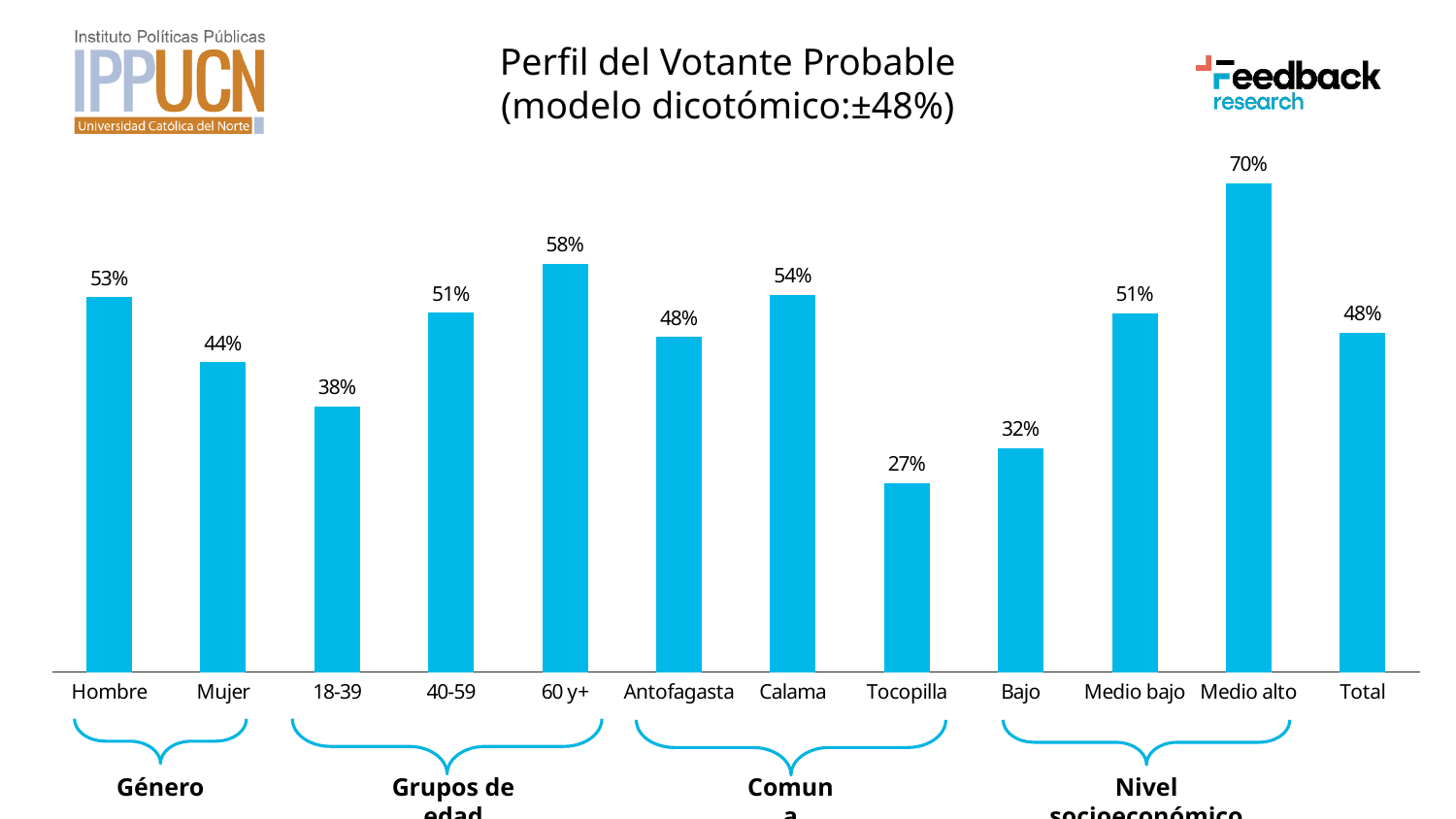
What is the value for Medio alto? 70% What is the difference between the values for 60 y+ and 18-39? 20% What is the value for Total? 48% What is the value for Hombre? 53% Do the values rise or fall across the age groups from 18-39 to 60 y+? Rise Which category has the highest value? Medio alto Which category has the lowest value? Tocopilla What kind of chart is shown on the slide? Bar chart What is the difference between the values for Hombre and Mujer? 9% Which is larger, the value for Calama or the value for Antofagasta? Calama How many bars are shown in the chart? 12 What is the value for Tocopilla? 27%